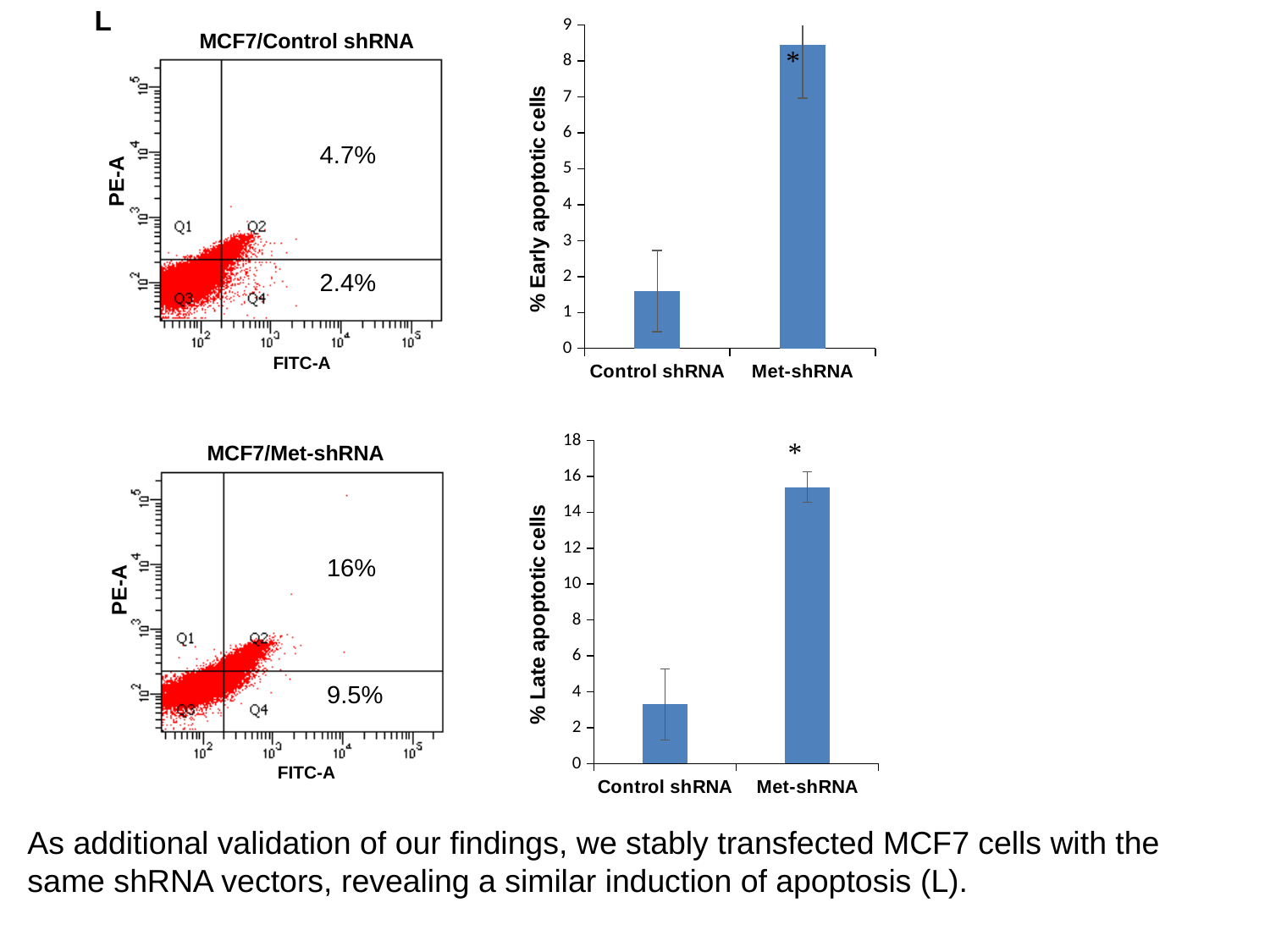
In the bottom-right '% Late apoptotic cells' chart, is the value for Control shRNA greater or less than 4? less What is the y-axis label of the bottom-right bar chart? % Late apoptotic cells In the bottom-right '% Late apoptotic cells' chart, is the value for Met-shRNA greater or less than 14? greater In the MCF7/Control shRNA flow cytometry plot, what percentage is printed in the upper-right quadrant (Q2)? 4.7% In the bottom-right '% Late apoptotic cells' chart, which is larger, Control shRNA or Met-shRNA? Met-shRNA In the top-right '% Early apoptotic cells' chart, which category has the higher bar? Met-shRNA How many categories are shown on the x axis of the bottom-right '% Late apoptotic cells' chart? 2 In the top-right '% Early apoptotic cells' chart, is the value for Control shRNA greater or less than 2? less In the top-right '% Early apoptotic cells' chart, which category has the lowest bar? Control shRNA What kind of chart is the top-right chart labelled '% Early apoptotic cells'? bar chart In the MCF7/Met-shRNA flow cytometry plot, what percentage is printed in the lower-right quadrant (Q4)? 9.5%